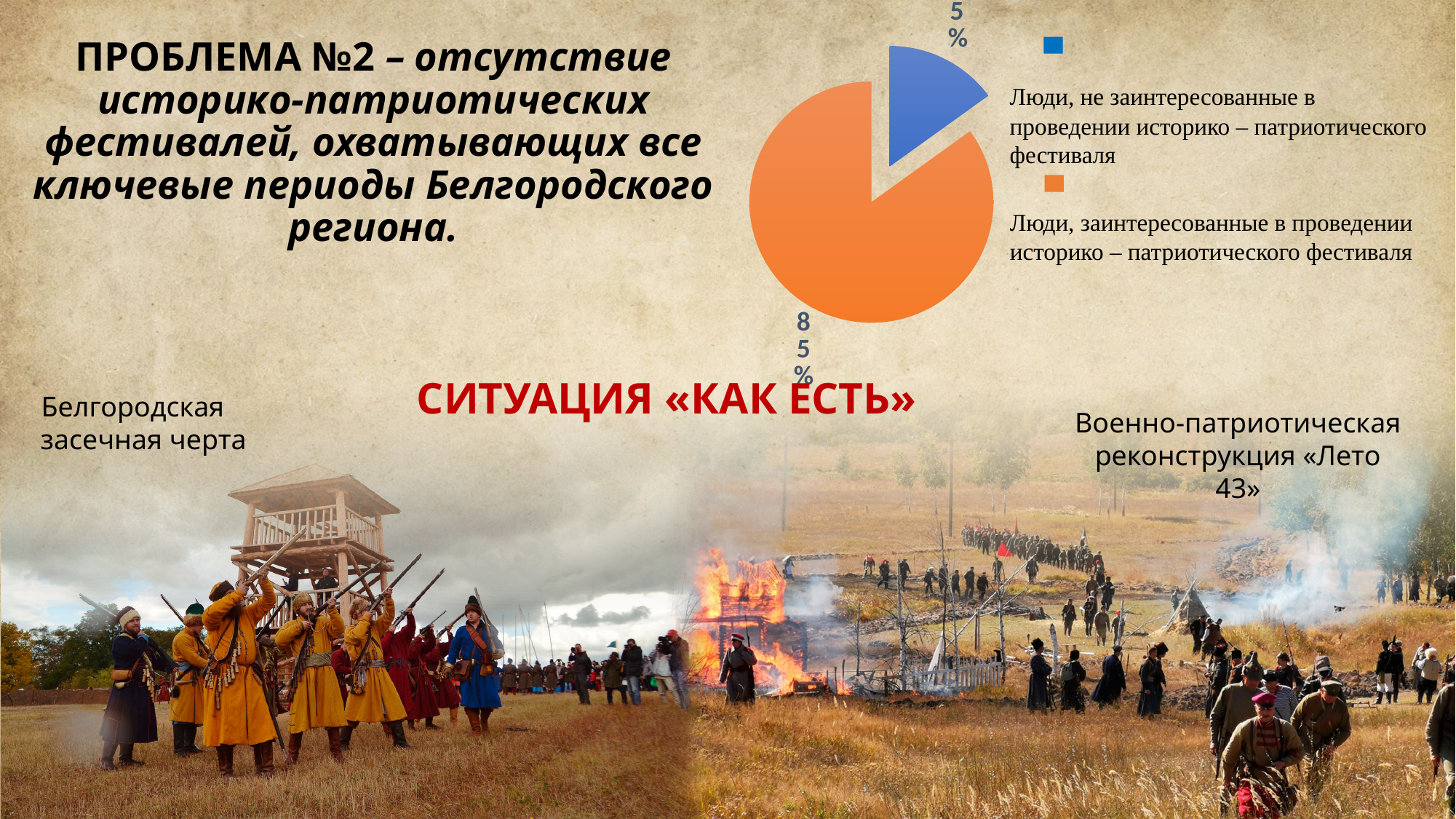
What colour is the slice for people interested in holding the festival? orange How many entries does the legend of the pie chart list? 2 What kind of chart is shown on the slide? pie chart Which category has the largest slice of the pie chart? Люди, заинтересованные в проведении историко – патриотического фестиваля What colour is the slice for people not interested in holding the festival? blue Which slice is larger: people interested in the festival or people not interested in the festival? people interested in the festival How many slices does the pie chart have? 2 Is the share of people not interested in the festival greater or less than 50%? less Which category has the smallest slice of the pie chart? Люди, не заинтересованные в проведении историко – патриотического фестиваля What percentage is shown for people interested in holding a historical-patriotic festival (Люди, заинтересованные в проведении историко – патриотического фестиваля)? 85% What share of the pie do people interested in holding the festival make up? 85%